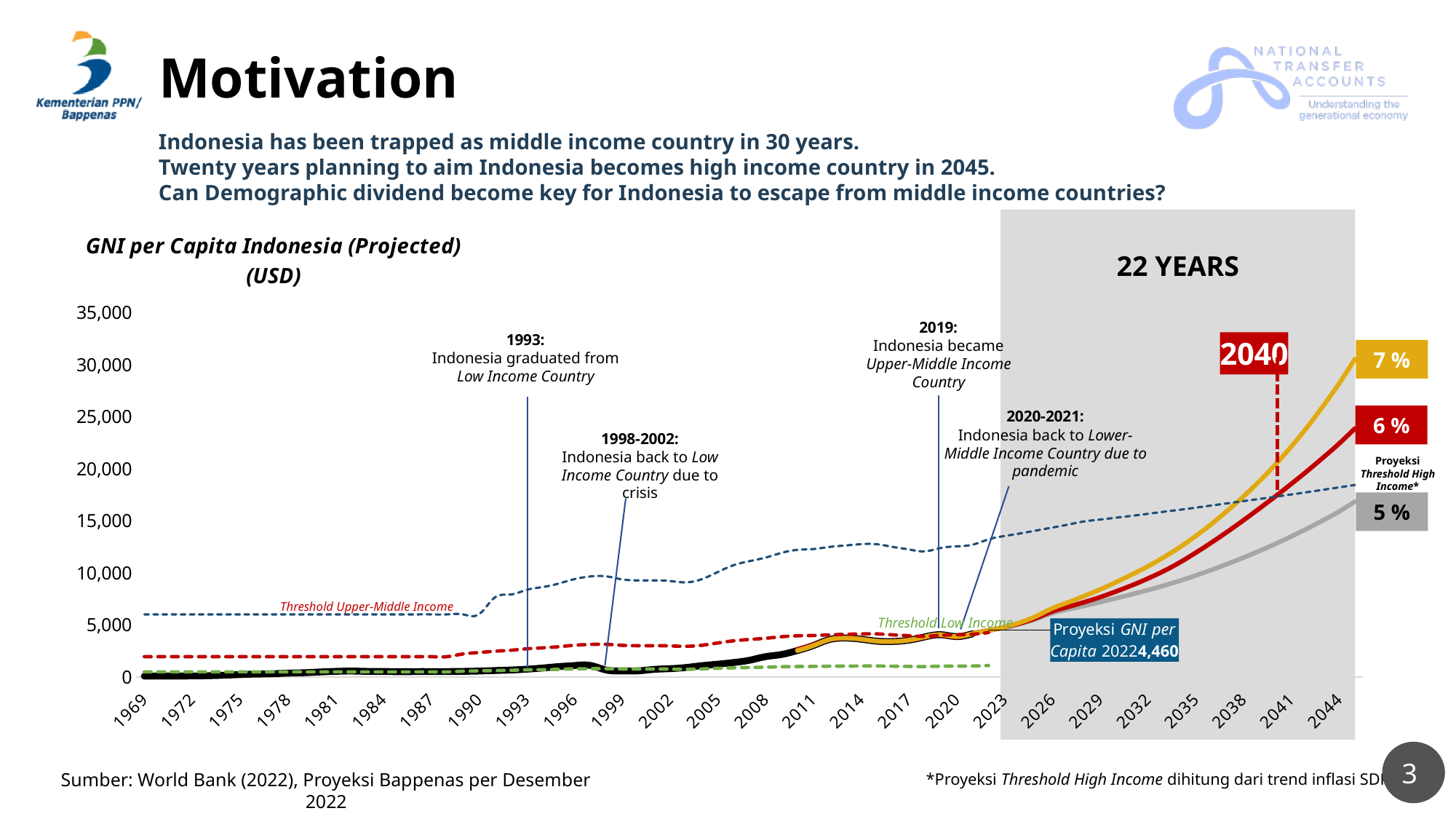
What is the highest value shown on the y axis? 35,000 Which growth scenario line reaches the highest GNI per capita by 2044? 7 % Is the value of the 7 % scenario line in 2044 greater or less than 25,000? greater What kind of chart is shown on the slide? line chart According to the chart annotation, in which year did Indonesia graduate from Low Income Country? 1993 Does the 7 % projection line rise or fall from 2023 to 2044? rise What is the title of the chart? GNI per Capita Indonesia (Projected) (USD) In 2044, which scenario line is higher, 6 % or 5 %? 6 % Which growth scenario line reaches the lowest GNI per capita by 2044? 5 % What is the projected GNI per capita for 2022 shown in the callout box? 4,460 How many growth-rate projection scenarios are plotted in the shaded projection area? 3 Is the value of the 5 % scenario line in 2044 greater or less than 20,000? less